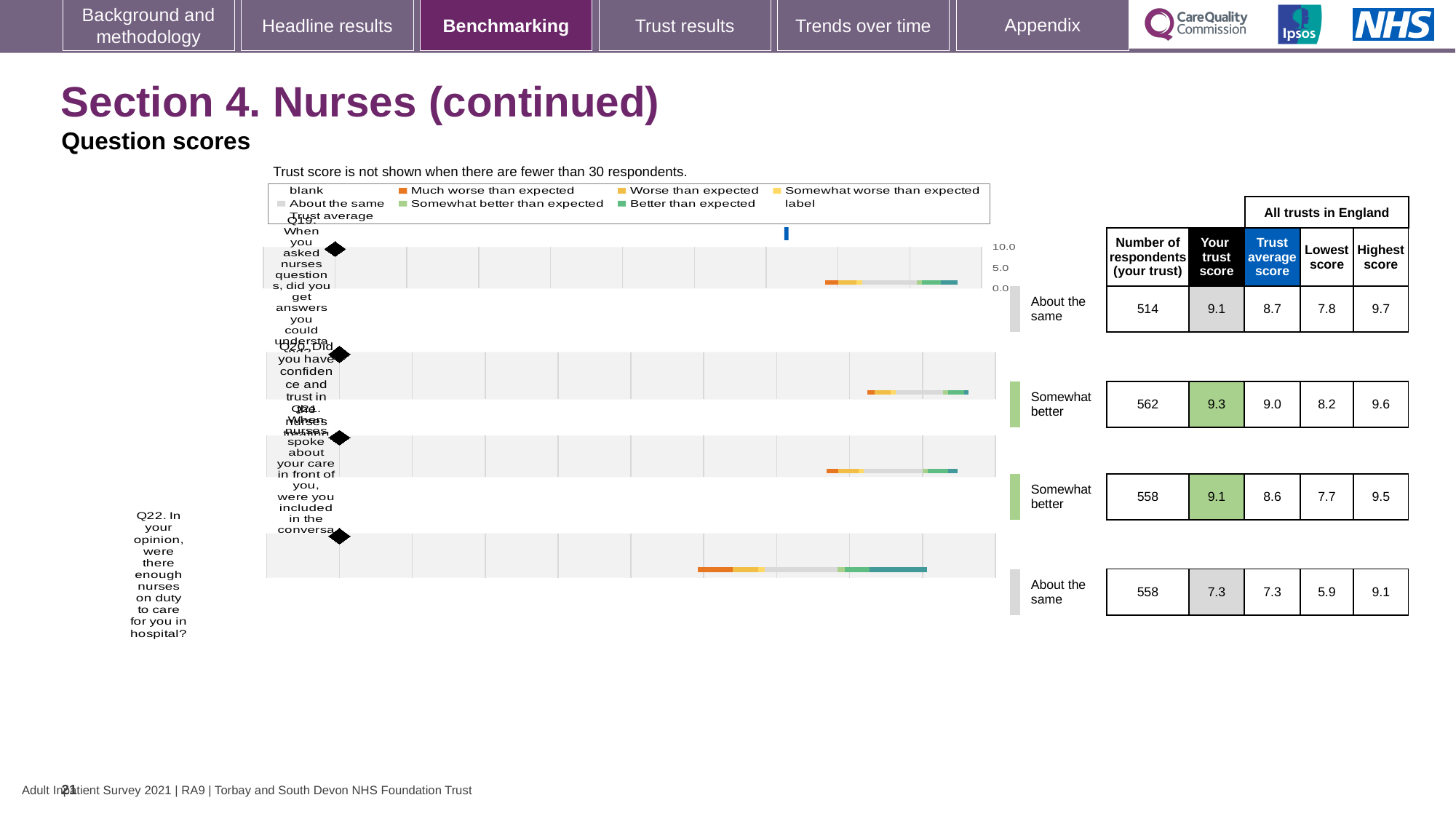
How many questions are plotted on this slide's chart? 4 How many respondents from your trust answered Q22 about whether there were enough nurses on duty? 558 What is the lowest score across all trusts in England for Q22? 5.9 What benchmark category is shown for Q20? Somewhat better What is the difference between the highest and lowest scores across all trusts in England for Q19? 1.9 For Q21, how much higher is your trust score than the trust average score? 0.5 Which question has the lowest 'Your trust score' on this slide? Q22 What is the trust average score for Q19 (getting answers you could understand from nurses)? 8.7 Which question has the highest 'Your trust score' on this slide? Q20 What is the highest score across all trusts in England for Q20? 9.6 What is your trust score for Q20 (confidence and trust in nurses)? 9.3 Which is larger: your trust score for Q19 or your trust score for Q22? Q19